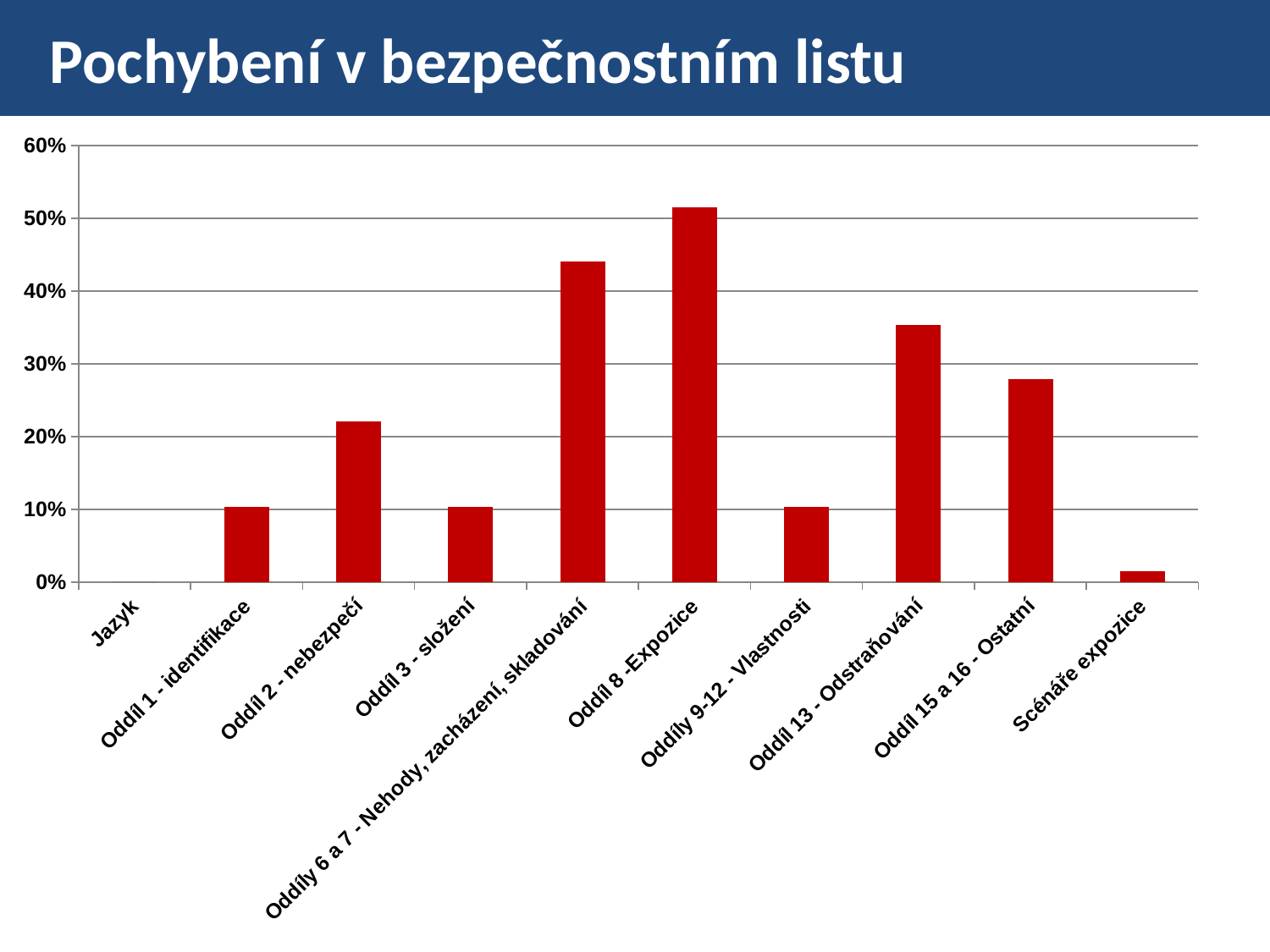
Which category has the highest value in the chart? Oddíl 8 -Expozice What is the title of the slide containing the chart? Pochybení v bezpečnostním listu Is the value for Scénáře expozice greater or less than 10%? less Is the value for Oddíl 8 -Expozice greater or less than 50%? greater Which category has the shortest visible bar in the chart? Scénáře expozice Is the value for Oddíl 13 - Odstraňování greater or less than 30%? greater How many categories are shown on the x axis of the chart? 10 Which has a larger value, Oddíl 13 - Odstraňování or Oddíl 15 a 16 - Ostatní? Oddíl 13 - Odstraňování What kind of chart is shown on the slide? bar chart Which has a larger value, Oddíl 2 - nebezpečí or Oddíl 3 - složení? Oddíl 2 - nebezpečí